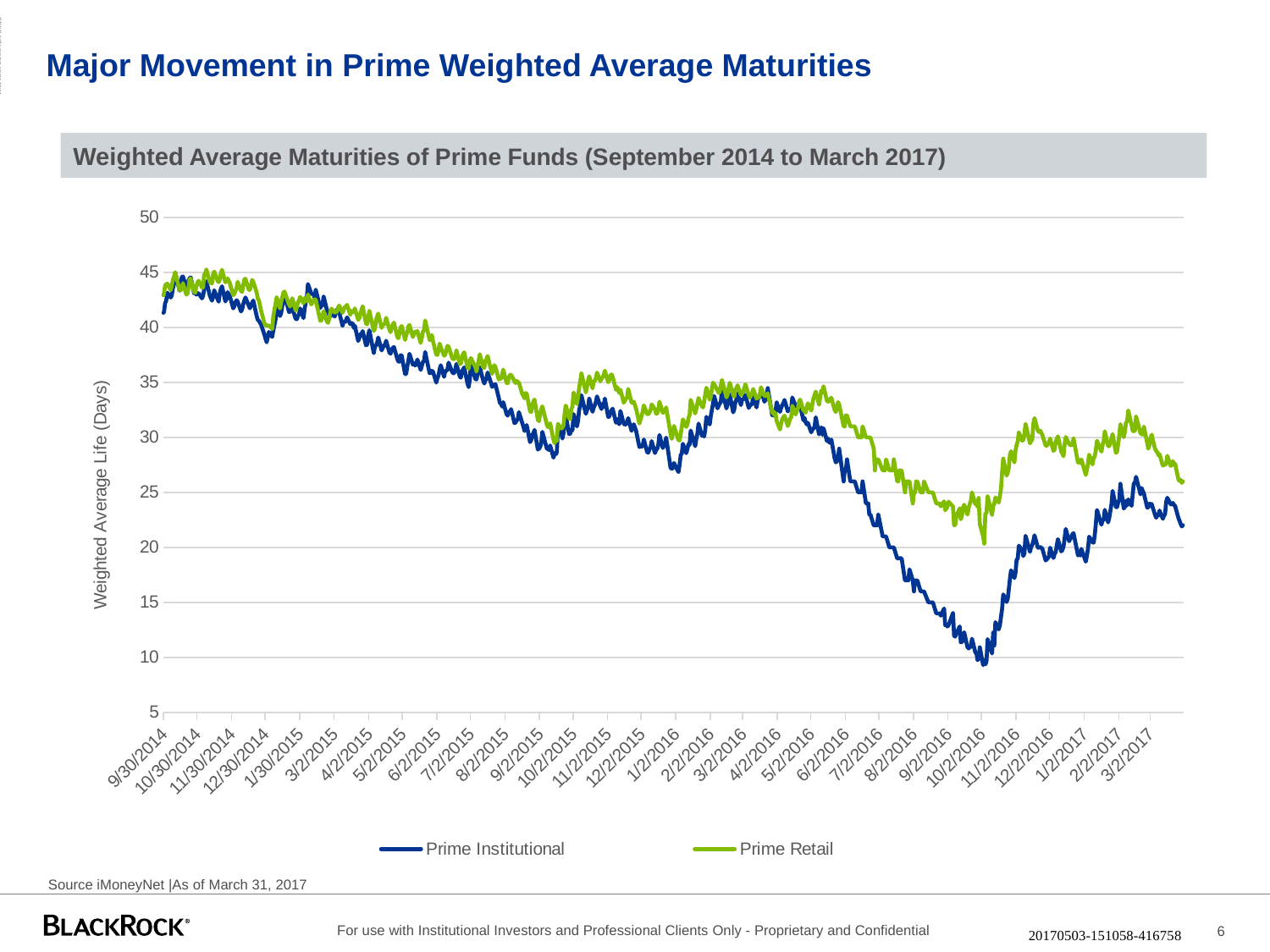
Is the value for Prime Retail at 3/2/2017 greater or less than 25? greater What is the label on the vertical axis of the chart? Weighted Average Life (Days) What kind of chart is shown on the slide? Line chart How many series does the legend list? 2 What is the title of the chart? Weighted Average Maturities of Prime Funds (September 2014 to March 2017) At 3/2/2017, which series has the higher value, Prime Institutional or Prime Retail? Prime Retail Is the value for Prime Institutional at 9/30/2014 greater or less than 40? greater At 10/2/2016, which series has the higher value, Prime Institutional or Prime Retail? Prime Retail Which series reaches the lowest point on the chart? Prime Institutional Is the value for Prime Retail at 9/2/2016 greater or less than 30? less Overall, do the values for Prime Institutional rise or fall from 9/30/2014 to 10/2/2016? fall